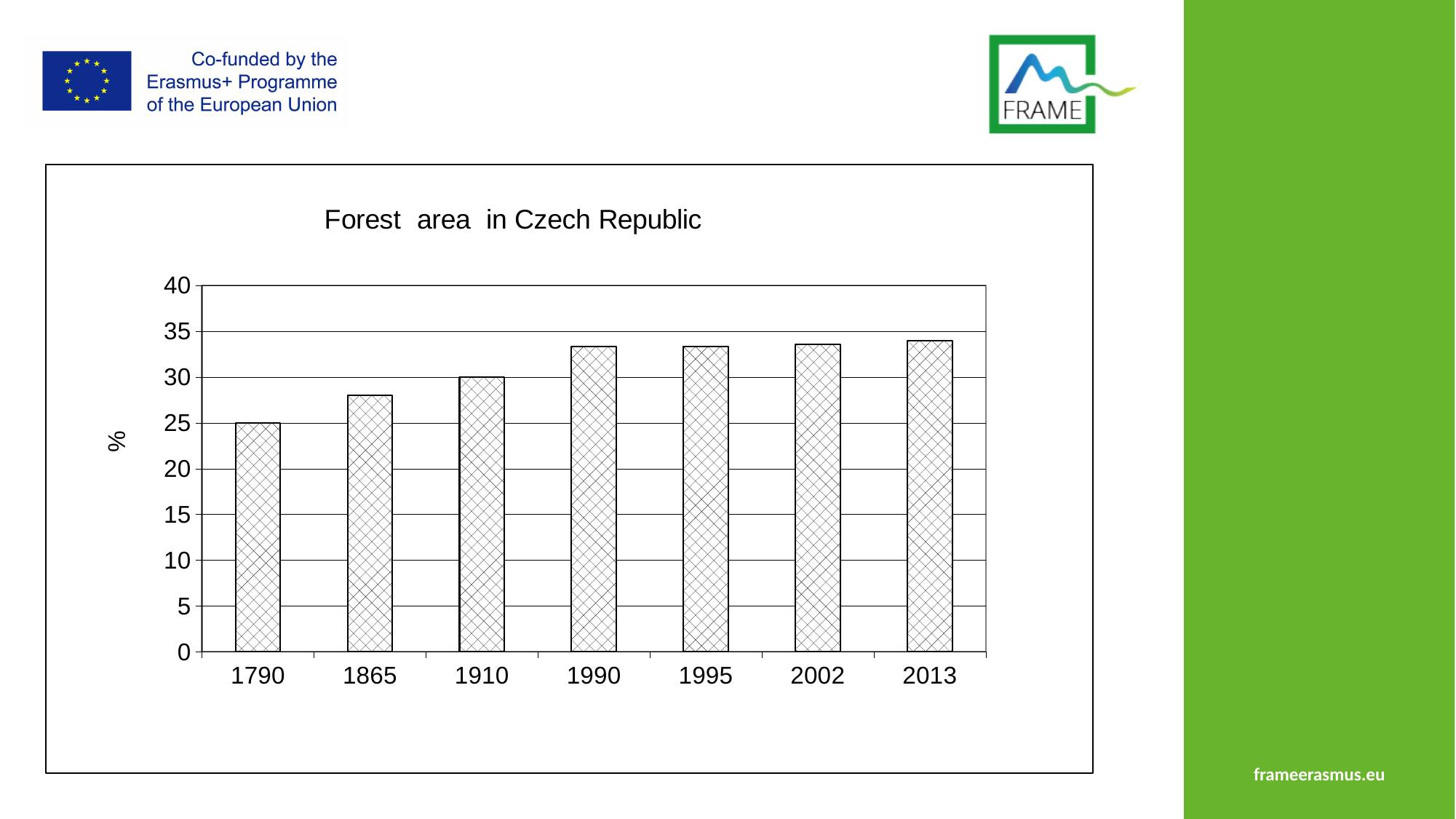
Is the value for 1990 greater or less than 30? greater Which year has the lowest forest area percentage? 1790 What is the title of the chart? Forest area in Czech Republic Is the value for 2013 greater or less than 35? less What is the forest area percentage for 1790? 25 Is the value for 1865 greater or less than 30? less What is the forest area percentage for 1910? 30 What type of chart is shown on the slide? bar chart Which is larger, the value for 1790 or the value for 1865? 1865 How many years are shown on the x axis of the chart? 7 Do the values rise or fall from 1790 to 2013? rise What is the label on the vertical axis of the chart? %